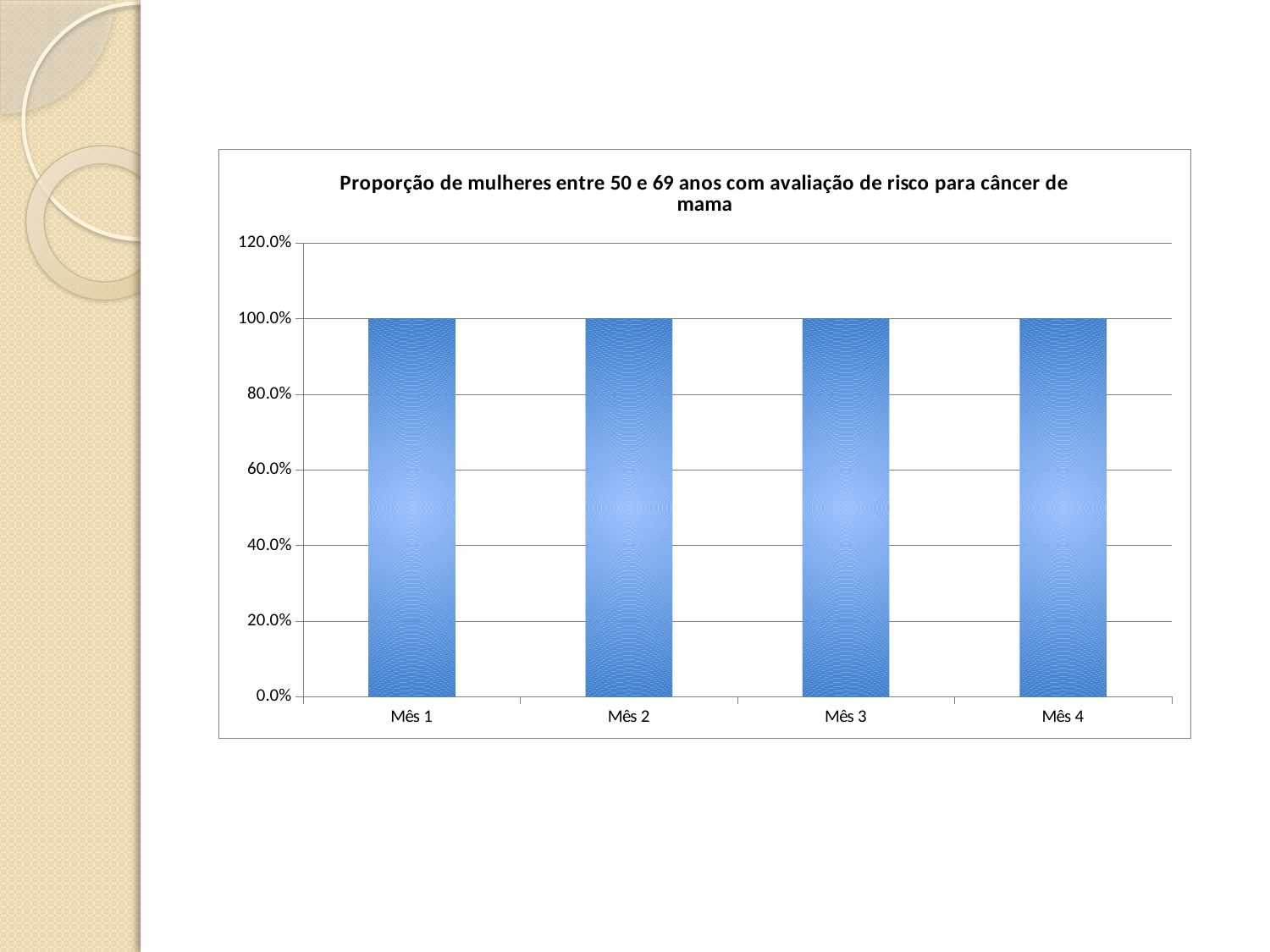
What is the title of the chart? Proporção de mulheres entre 50 e 69 anos com avaliação de risco para câncer de mama What is the value for Mês 1? 100.0% What kind of chart is this? bar chart Is the value for Mês 2 greater or less than 80.0%? greater Is the value for Mês 4 greater or less than 120.0%? less What is the value for Mês 3? 100.0% Do the values rise, fall, or stay the same from Mês 1 to Mês 4? stay the same What is the highest value shown on the y axis? 120.0% What is the difference between the values for Mês 1 and Mês 2? 0.0% How many categories (months) are shown on the x axis? 4 What is the value for Mês 4? 100.0%